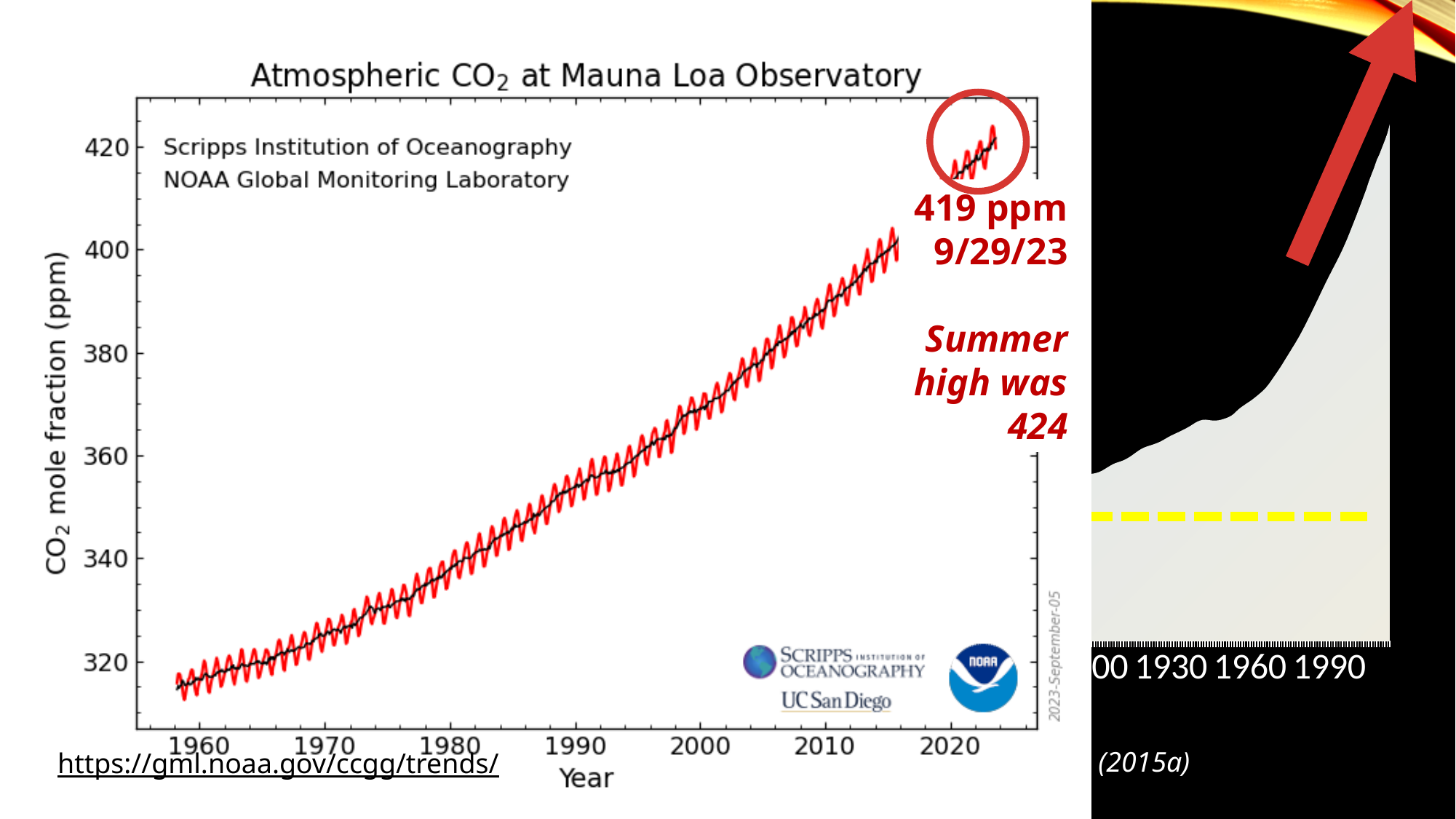
According to the annotation on the Mauna Loa CO2 chart, what was the summer high CO2 value? 424 On the Mauna Loa CO2 chart, is the value around 1960 greater or less than 320? less On the Mauna Loa CO2 chart, is the value around 2000 greater or less than 360? greater What is the title of the chart on the left of the slide? Atmospheric CO2 at Mauna Loa Observatory On the Mauna Loa CO2 chart, is the value around 2020 greater or less than 400? greater According to the annotation on the Mauna Loa CO2 chart, what was the CO2 value on 9/29/23? 419 ppm What kind of chart is the Atmospheric CO2 at Mauna Loa Observatory chart? Line chart On the Mauna Loa CO2 chart, how much higher was the annotated summer high (424) than the 9/29/23 value (419 ppm)? 5 ppm What is the label of the y axis on the Mauna Loa CO2 chart? CO2 mole fraction (ppm) Do the CO2 values on the Mauna Loa chart rise or fall from 1960 to 2020? Rise